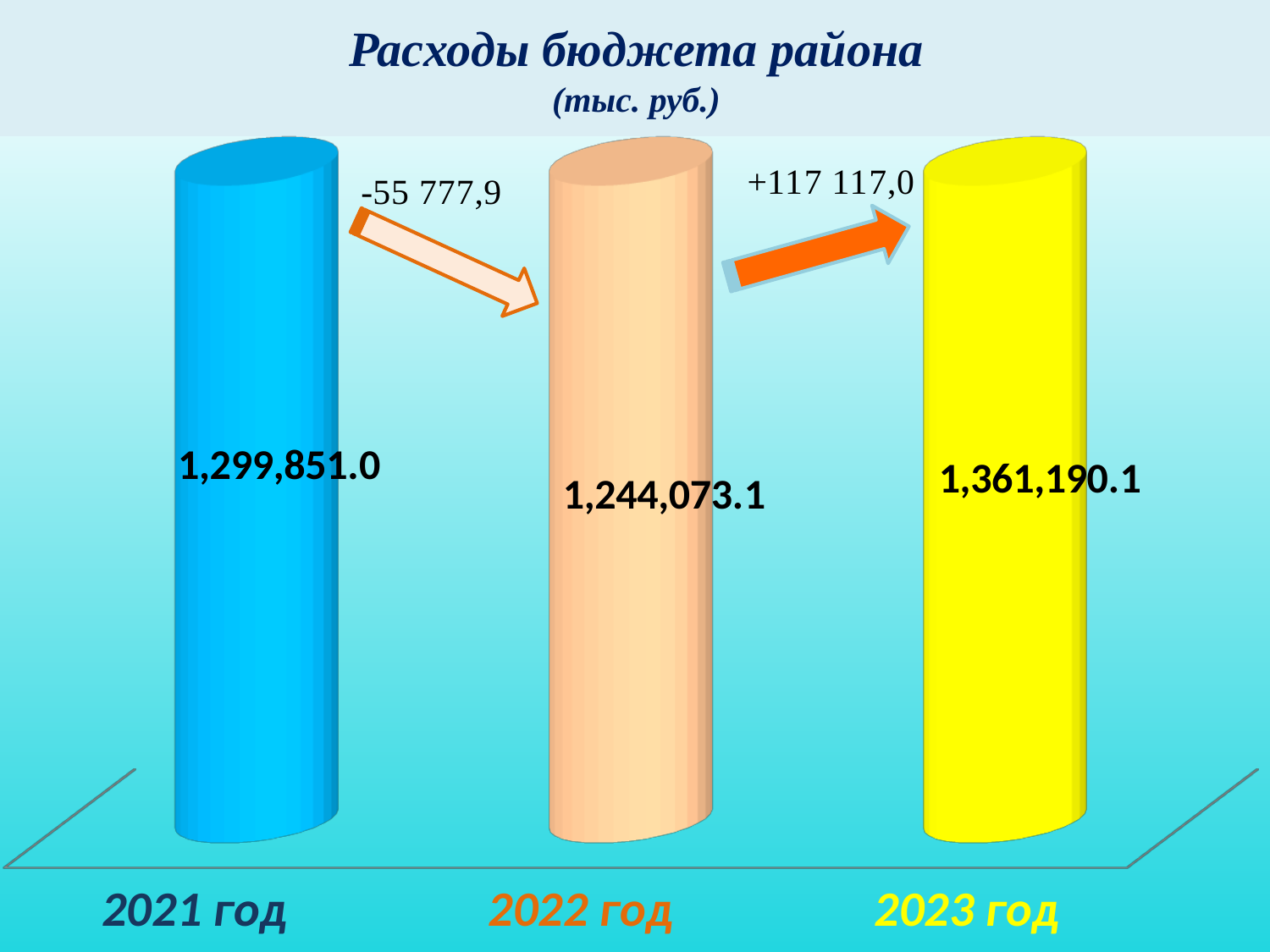
What is the difference between the values for 2021 год and 2022 год? 55,777.9 How many years are shown on the chart? 3 What kind of chart is shown on the slide? bar chart What is the value for 2021 год? 1,299,851.0 Which year has the highest value? 2023 год What is the value for 2023 год? 1,361,190.1 What is the difference between the values for 2023 год and 2022 год? 117,117.0 Which is larger, the value for 2021 год or the value for 2023 год? 2023 год Which year has the lowest value? 2022 год What is the title of the chart? Расходы бюджета района (тыс. руб.) What is the value for 2022 год? 1,244,073.1 What change is written on the arrow between 2022 год and 2023 год? +117 117,0